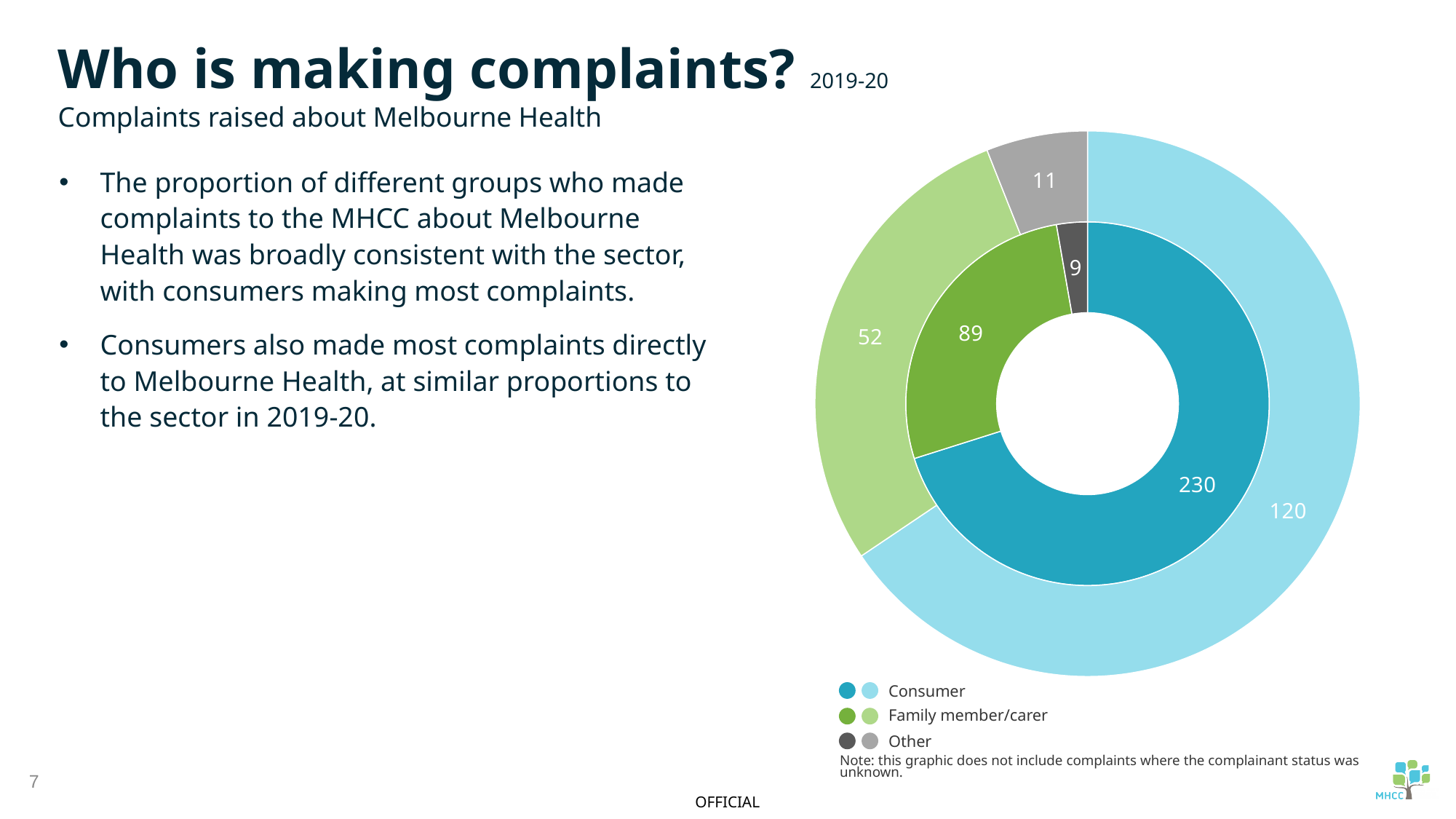
In the inner ring, is the value for Family member/carer larger or smaller than the value for Other? Larger What kind of chart is shown on the slide? Doughnut chart What is the total of the three values in the outer ring of the doughnut chart? 183 In the inner ring of the doughnut chart, what is the value for Consumer? 230 In the outer ring of the doughnut chart, what is the value for Other? 11 What is the difference between the Consumer value and the Family member/carer value in the inner ring? 141 In the inner ring of the doughnut chart, what is the value for Family member/carer? 89 What is the difference between the Family member/carer value and the Other value in the outer ring? 41 Which category has the smallest value in the outer ring of the doughnut chart? Other Which category has the largest value in the inner ring of the doughnut chart? Consumer How many categories does the legend of the doughnut chart list? 3 In the outer ring of the doughnut chart, what is the value for Consumer? 120